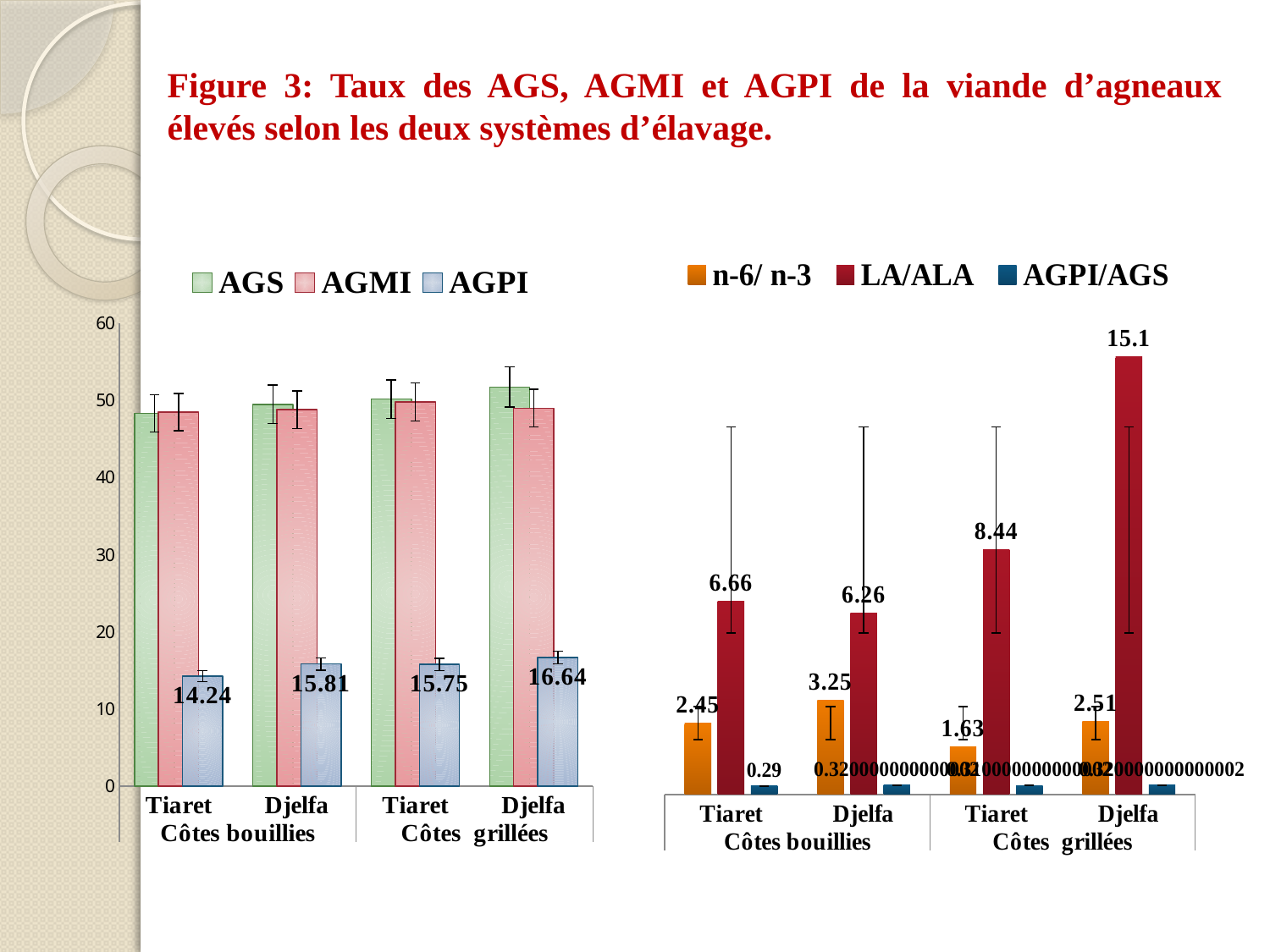
In the left chart, is the AGS value for Djelfa, Côtes grillées greater or less than 40? greater In the right chart, what is the LA/ALA value for Djelfa, Côtes grillées? 15.1 In the right chart, what is the difference between the LA/ALA values for Djelfa, Côtes grillées and Tiaret, Côtes grillées? 6.66 What kind of chart is the right chart? bar chart In the right chart, what is the n-6/ n-3 value for Djelfa, Côtes bouillies? 3.25 In the left chart, what is the AGPI value for Tiaret, Côtes bouillies? 14.24 In the left chart, which category has the highest AGPI value? Djelfa, Côtes grillées In the left chart, what is the AGPI value for Djelfa, Côtes grillées? 16.64 In the left chart, what is the difference between the AGPI values for Djelfa, Côtes bouillies and Tiaret, Côtes bouillies? 1.57 In the left chart, how many series does the legend list? 3 In the right chart, which category has the lowest n-6/ n-3 value? Tiaret, Côtes grillées In the right chart, which is larger: the LA/ALA value for Tiaret, Côtes bouillies or for Djelfa, Côtes bouillies? Tiaret, Côtes bouillies